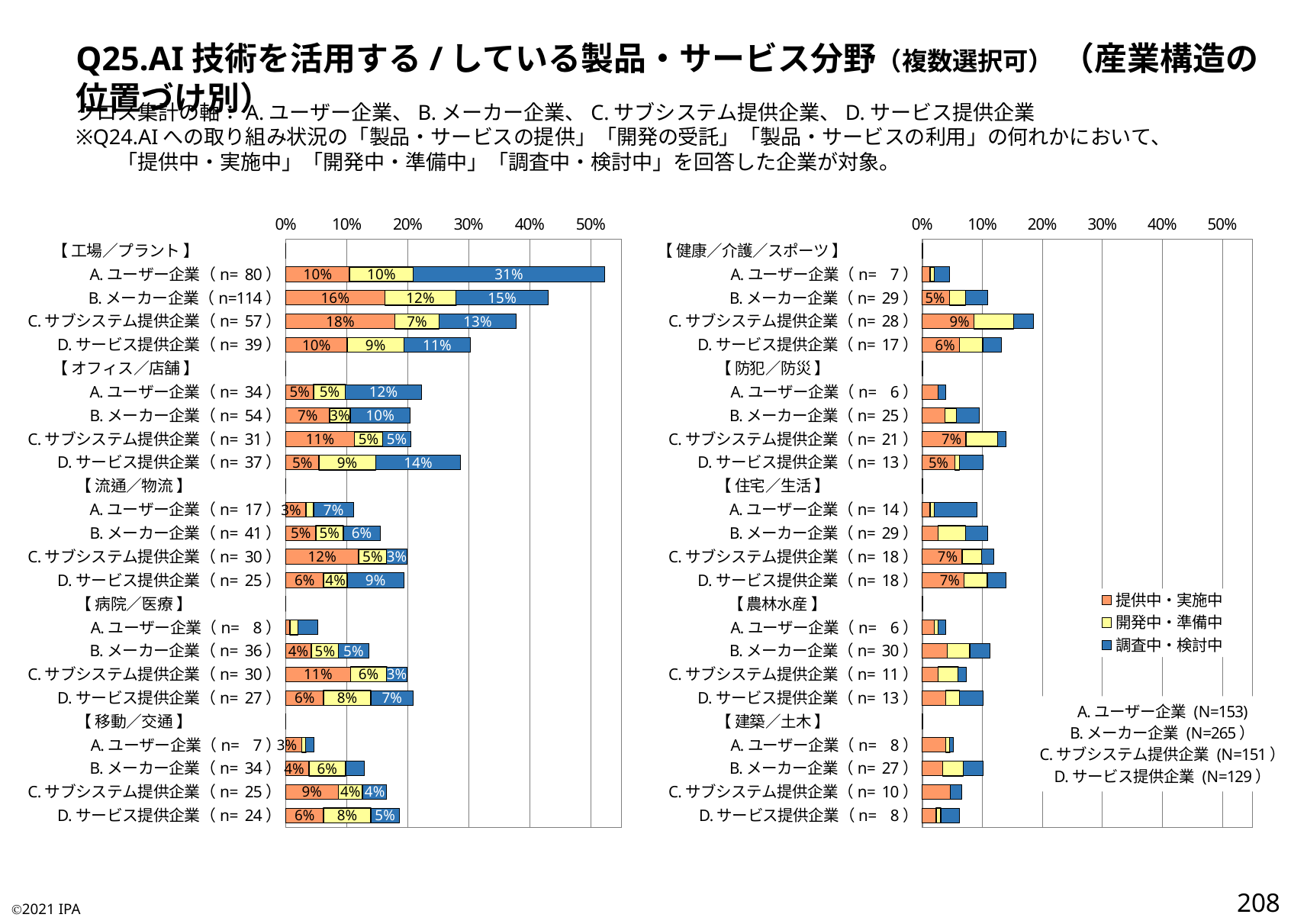
On the right chart, is the total bar for C. サブシステム提供企業 under 【健康／介護／スポーツ】 greater or less than 10%? greater On the left chart, what is the total of the stacked bar for A. ユーザー企業 under 【工場／プラント】? 51% On the left chart, what is the total of the stacked bar for C. サブシステム提供企業 under 【工場／プラント】? 38% On the right chart, what is the 提供中・実施中 value for C. サブシステム提供企業 under 【健康／介護／スポーツ】? 9% What kind of chart is used on this slide? Stacked horizontal bar chart How many series does the legend list? 3 On the left chart, under 【工場／プラント】, which company type has the longest total bar? A. ユーザー企業 On the left chart, what is the 調査中・検討中 value for A. ユーザー企業 under 【工場／プラント】? 31% On the left chart, under 【工場／プラント】, which has the larger 調査中・検討中 value: A. ユーザー企業 or B. メーカー企業? A. ユーザー企業 On the left chart, under 【工場／プラント】, what is the difference between the 提供中・実施中 values for C. サブシステム提供企業 and D. サービス提供企業? 8 percentage points On the left chart, what is the 調査中・検討中 value for D. サービス提供企業 under 【オフィス／店舗】? 14% On the left chart, what is the 提供中・実施中 value for B. メーカー企業 under 【工場／プラント】? 16%